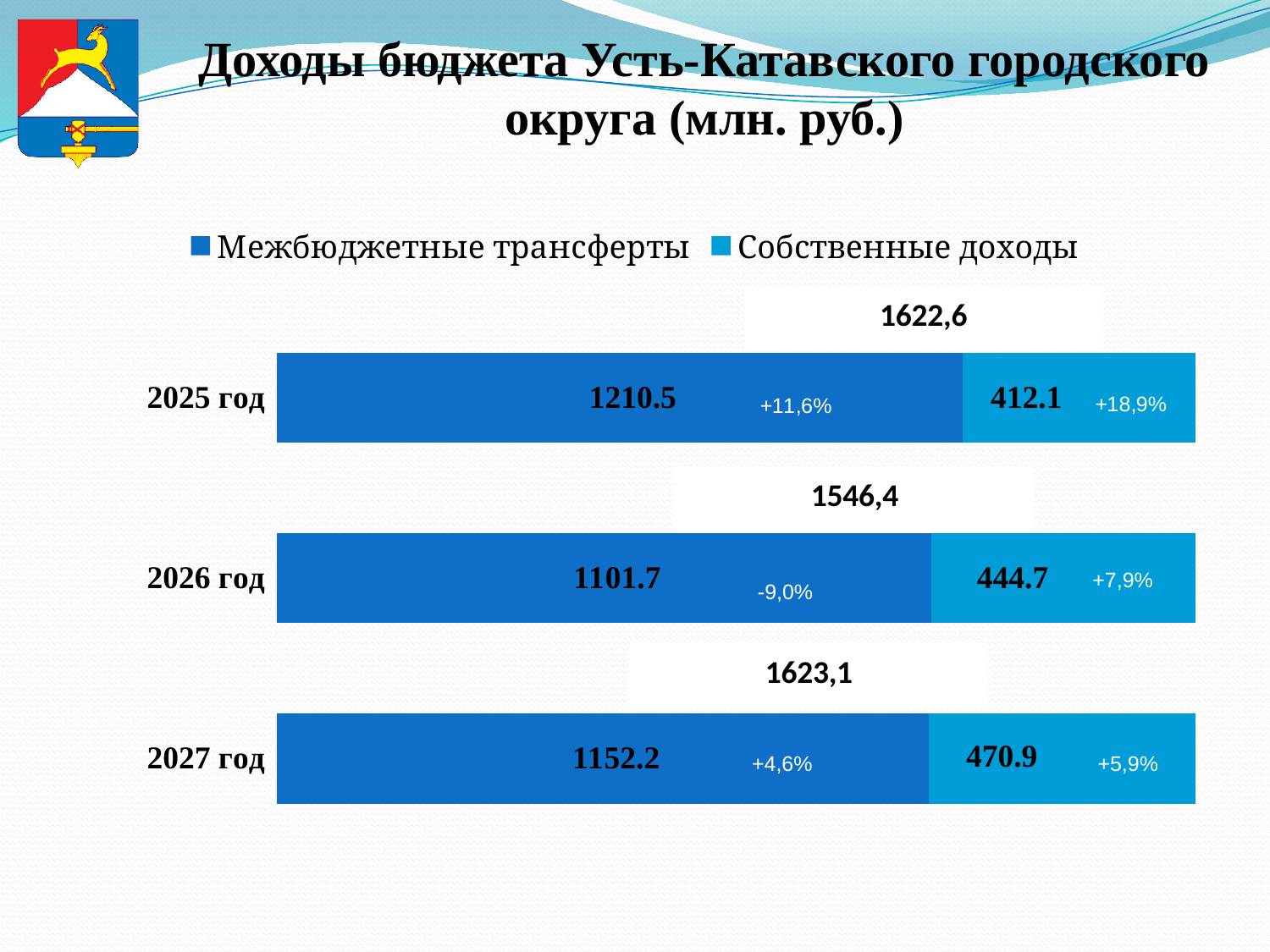
Which year has the lowest value for Межбюджетные трансферты? 2026 год What kind of chart is shown on the slide? Stacked bar chart What is the value of Межбюджетные трансферты for 2025 год? 1210.5 What is the difference between Межбюджетные трансферты in 2025 год and 2026 год? 108.8 How many series does the legend list? 2 Which year has the highest value for Собственные доходы? 2027 год What is the value of Собственные доходы for 2027 год? 470.9 Which is larger: Собственные доходы in 2025 год or in 2026 год? 2026 год How many years are shown in the chart? 3 What is the value of Собственные доходы for 2026 год? 444.7 What is the total shown above the bar for 2027 год? 1623,1 What is the total shown above the bar for 2026 год? 1546,4